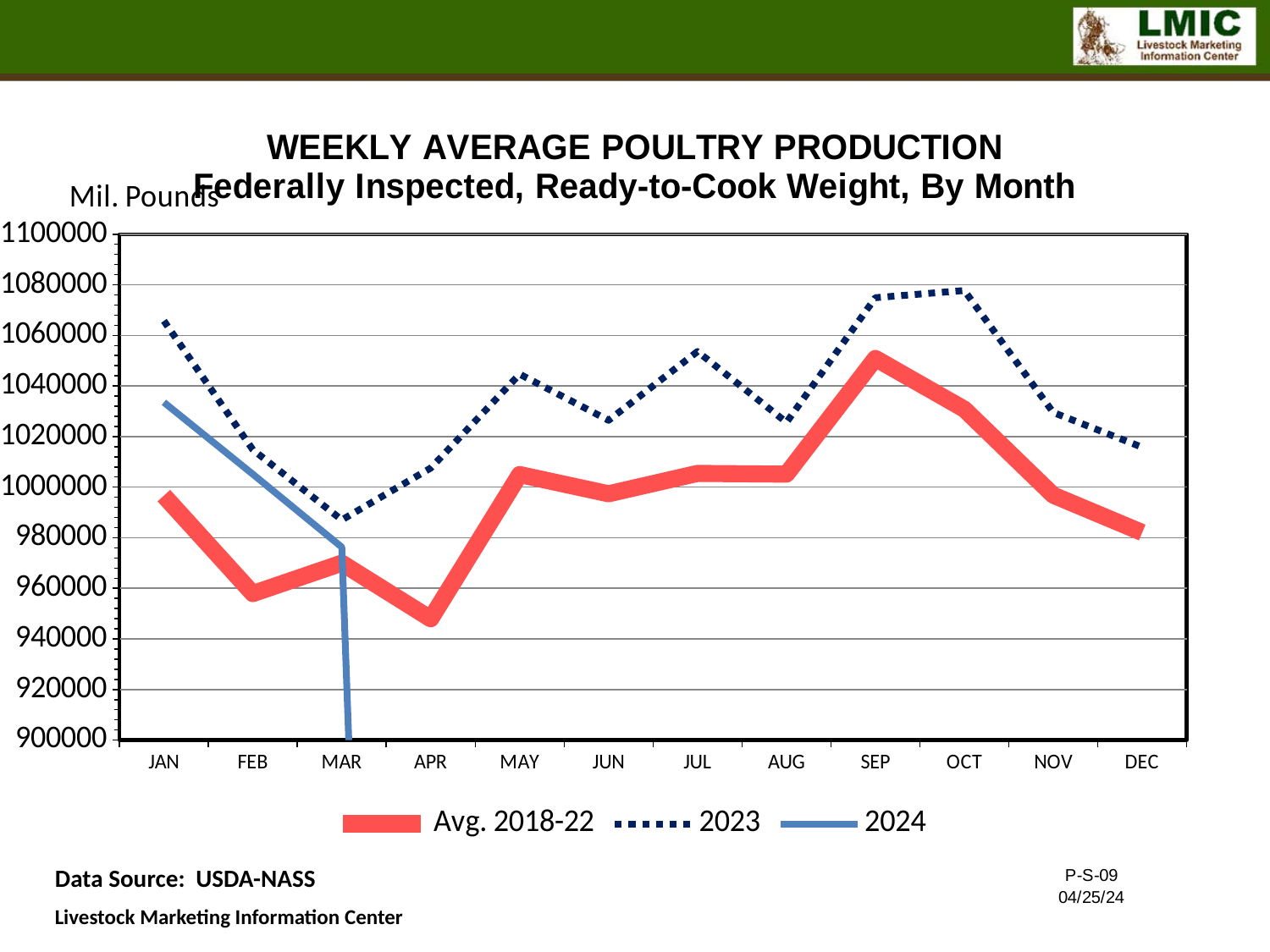
What unit label is shown above the y axis? Mil. Pounds In which month does the Avg. 2018-22 series reach its highest value? SEP Does the Avg. 2018-22 series rise or fall from SEP to DEC? fall In which month does the Avg. 2018-22 series reach its lowest value? APR In JAN, which series has the higher value, 2023 or Avg. 2018-22? 2023 Is the 2024 value for JAN greater or less than 1020000? greater In which month does the 2023 series reach its lowest value? MAR Is the Avg. 2018-22 value for APR greater or less than 960000? less Is the 2023 value for JAN greater or less than 1040000? greater What kind of chart is shown on the slide? line chart How many months are shown along the x axis? 12 How many series does the legend list? 3